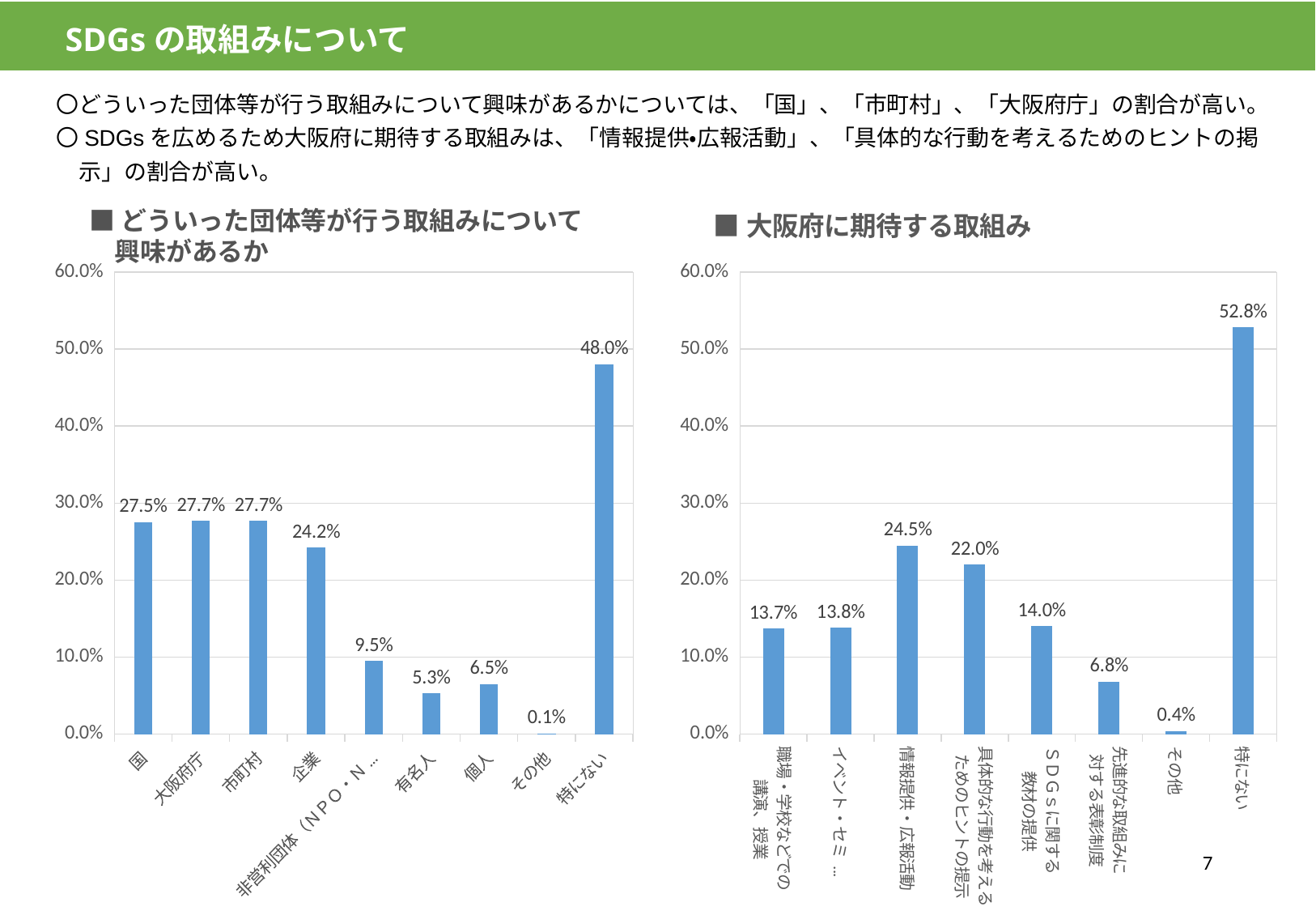
In the chart titled 「どういった団体等が行う取組みについて興味があるか」, what is the difference between 特にない and 企業? 23.8% In the chart titled 「大阪府に期待する取組み」, what is the value for 特にない? 52.8% In the chart titled 「どういった団体等が行う取組みについて興味があるか」, what is the value for 国? 27.5% In the chart titled 「どういった団体等が行う取組みについて興味があるか」, which category has the lowest value? その他 In the chart titled 「どういった団体等が行う取組みについて興味があるか」, how many categories are plotted? 9 In the chart titled 「大阪府に期待する取組み」, what is the value for 情報提供・広報活動? 24.5% In the chart titled 「どういった団体等が行う取組みについて興味があるか」, which is larger, 有名人 or 個人? 個人 In the chart titled 「大阪府に期待する取組み」, which category has the lowest value? その他 In the chart titled 「大阪府に期待する取組み」, what is the difference between 情報提供・広報活動 and 具体的な行動を考えるためのヒントの提示? 2.5% In the chart titled 「大阪府に期待する取組み」, how many categories are plotted? 8 In the chart titled 「どういった団体等が行う取組みについて興味があるか」, which category has the highest value? 特にない What kind of chart is the chart titled 「大阪府に期待する取組み」? Bar chart